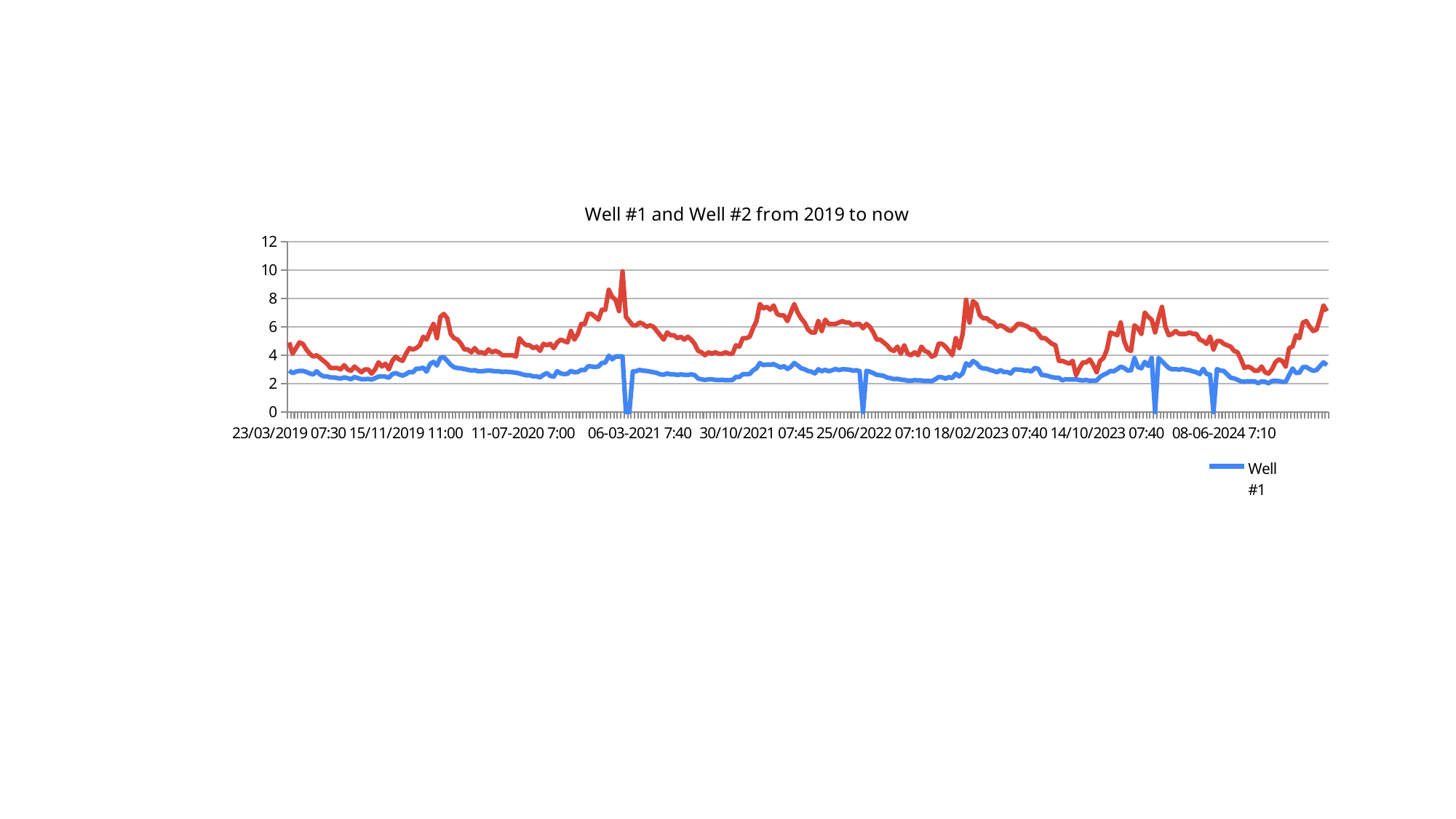
Is the highest point of the red line greater or less than 8? greater Which line reaches the highest value anywhere on the chart, the red line or the blue Well #1 line? The red line At 25/06/2022 07:10, which line has the higher value, the red line or the blue Well #1 line? The red line How many times does the blue Well #1 line drop down to 0? 4 What is the title of the chart? Well #1 and Well #2 from 2019 to now How many lines are plotted on the chart? 2 How many date labels are shown along the x axis? 9 Which series name is shown in the chart legend? Well #1 Is the value of the blue Well #1 line at 23/03/2019 07:30 greater or less than 4? less What kind of chart is shown on the slide? Line chart Is the value of the red line at 25/06/2022 07:10 greater or less than 4? greater What is the highest value shown on the y axis? 12